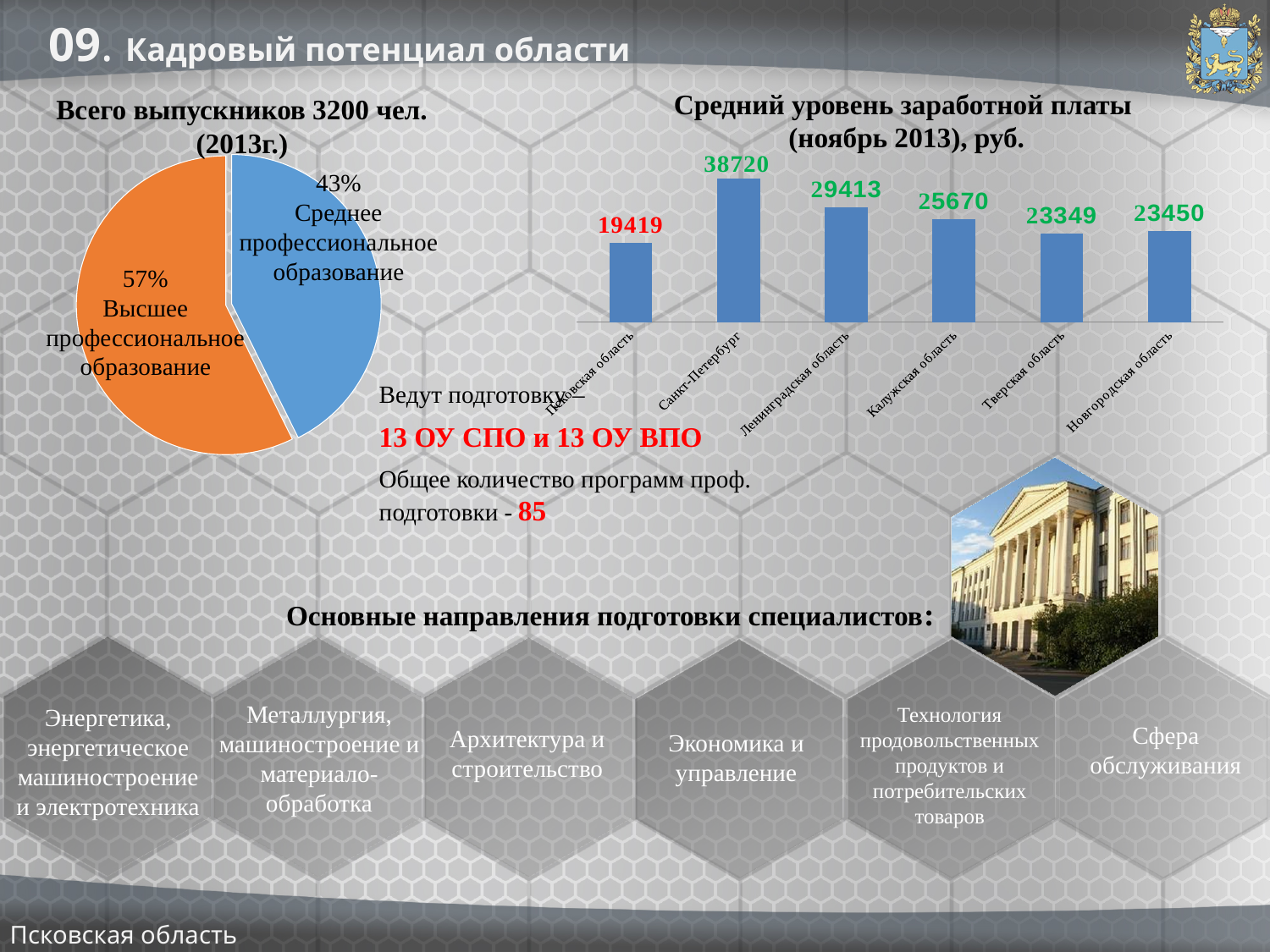
On the bar chart 'Средний уровень заработной платы (ноябрь 2013), руб.', what is the value for Ленинградская область? 29413 On the pie chart 'Всего выпускников 3200 чел. (2013г.)', what share is Среднее профессиональное образование? 43% On the bar chart 'Средний уровень заработной платы (ноябрь 2013), руб.', what is the difference between Санкт-Петербург and Ленинградская область? 9307 On the bar chart 'Средний уровень заработной платы (ноябрь 2013), руб.', what is the value for Санкт-Петербург? 38720 On the bar chart 'Средний уровень заработной платы (ноябрь 2013), руб.', what is the value of the leftmost bar (shown in red)? 19419 On the bar chart 'Средний уровень заработной платы (ноябрь 2013), руб.', what is the value for Калужская область? 25670 On the bar chart 'Средний уровень заработной платы (ноябрь 2013), руб.', which is larger: Калужская область or Тверская область? Калужская область How many bars are on the bar chart 'Средний уровень заработной платы (ноябрь 2013), руб.'? 6 On the bar chart 'Средний уровень заработной платы (ноябрь 2013), руб.', what is the value for Новгородская область? 23450 What type of chart is the chart on the left of the slide, titled 'Всего выпускников 3200 чел. (2013г.)'? pie chart On the bar chart 'Средний уровень заработной платы (ноябрь 2013), руб.', which region has the highest value? Санкт-Петербург On the pie chart 'Всего выпускников 3200 чел. (2013г.)', what share is Высшее профессиональное образование? 57%